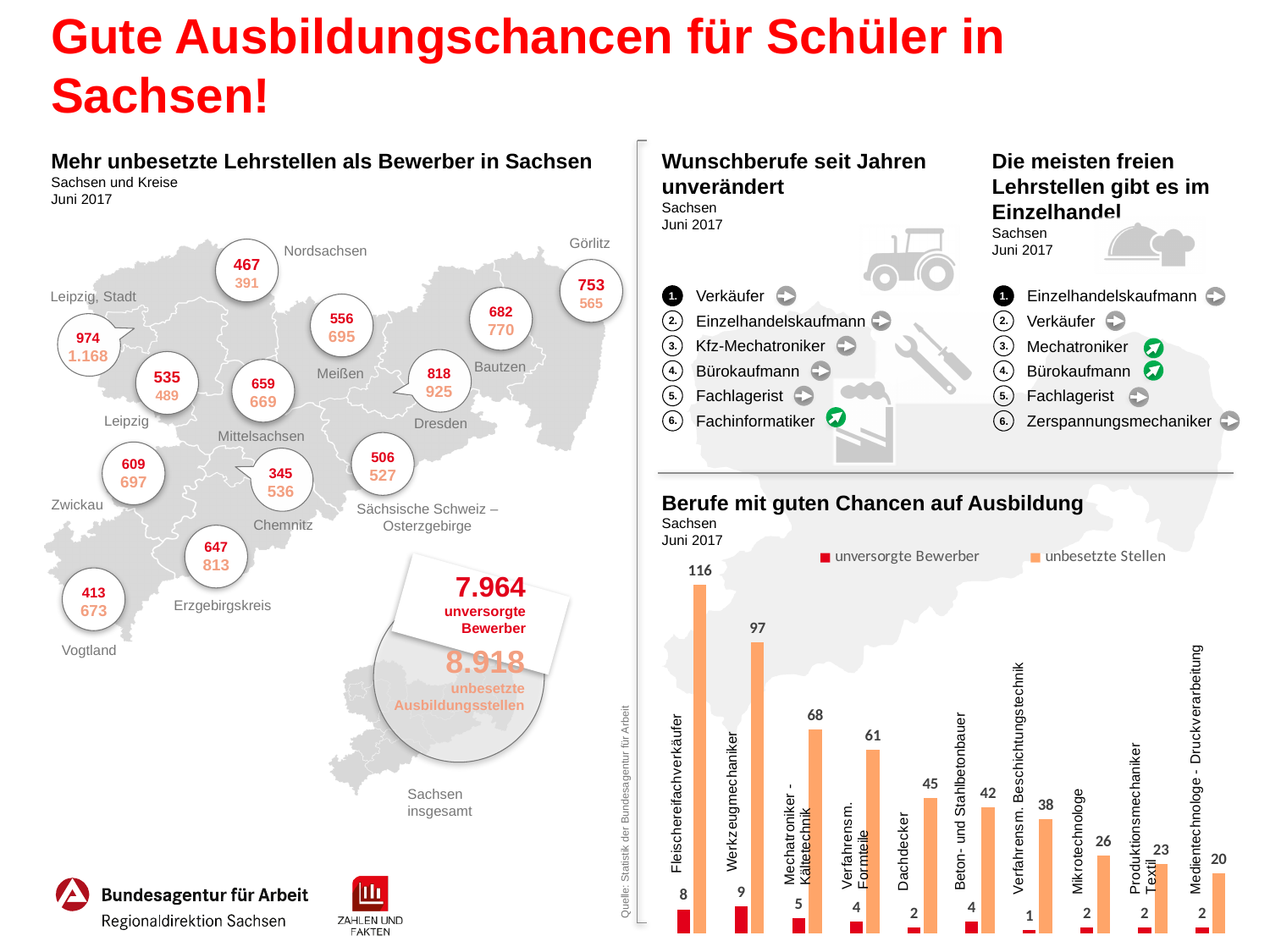
In the chart 'Berufe mit guten Chancen auf Ausbildung', which occupation has the lowest number of unbesetzte Stellen? Medientechnologe - Druckverarbeitung In the chart 'Berufe mit guten Chancen auf Ausbildung', which occupation has the highest number of unbesetzte Stellen? Fleischereifachverkäufer In the chart 'Berufe mit guten Chancen auf Ausbildung', which colour represents unbesetzte Stellen? Orange In the chart 'Berufe mit guten Chancen auf Ausbildung', which has more unbesetzte Stellen: Mechatroniker - Kältetechnik or Verfahrensm. Formteile? Mechatroniker - Kältetechnik In the chart 'Berufe mit guten Chancen auf Ausbildung', what is the value of unbesetzte Stellen for Fleischereifachverkäufer? 116 In the chart 'Berufe mit guten Chancen auf Ausbildung', what is the value of unversorgte Bewerber for Werkzeugmechaniker? 9 In the chart 'Berufe mit guten Chancen auf Ausbildung', how many series does the legend list? 2 In the chart 'Berufe mit guten Chancen auf Ausbildung', what is the value of unversorgte Bewerber for Verfahrensm. Beschichtungstechnik? 1 In the chart 'Berufe mit guten Chancen auf Ausbildung', what is the difference between unbesetzte Stellen and unversorgte Bewerber for Dachdecker? 43 What kind of chart is 'Berufe mit guten Chancen auf Ausbildung'? Bar chart In the chart 'Berufe mit guten Chancen auf Ausbildung', how many occupations are shown on the x axis? 10 In the chart 'Berufe mit guten Chancen auf Ausbildung', do the unbesetzte Stellen values rise or fall from left to right along the x axis? Fall